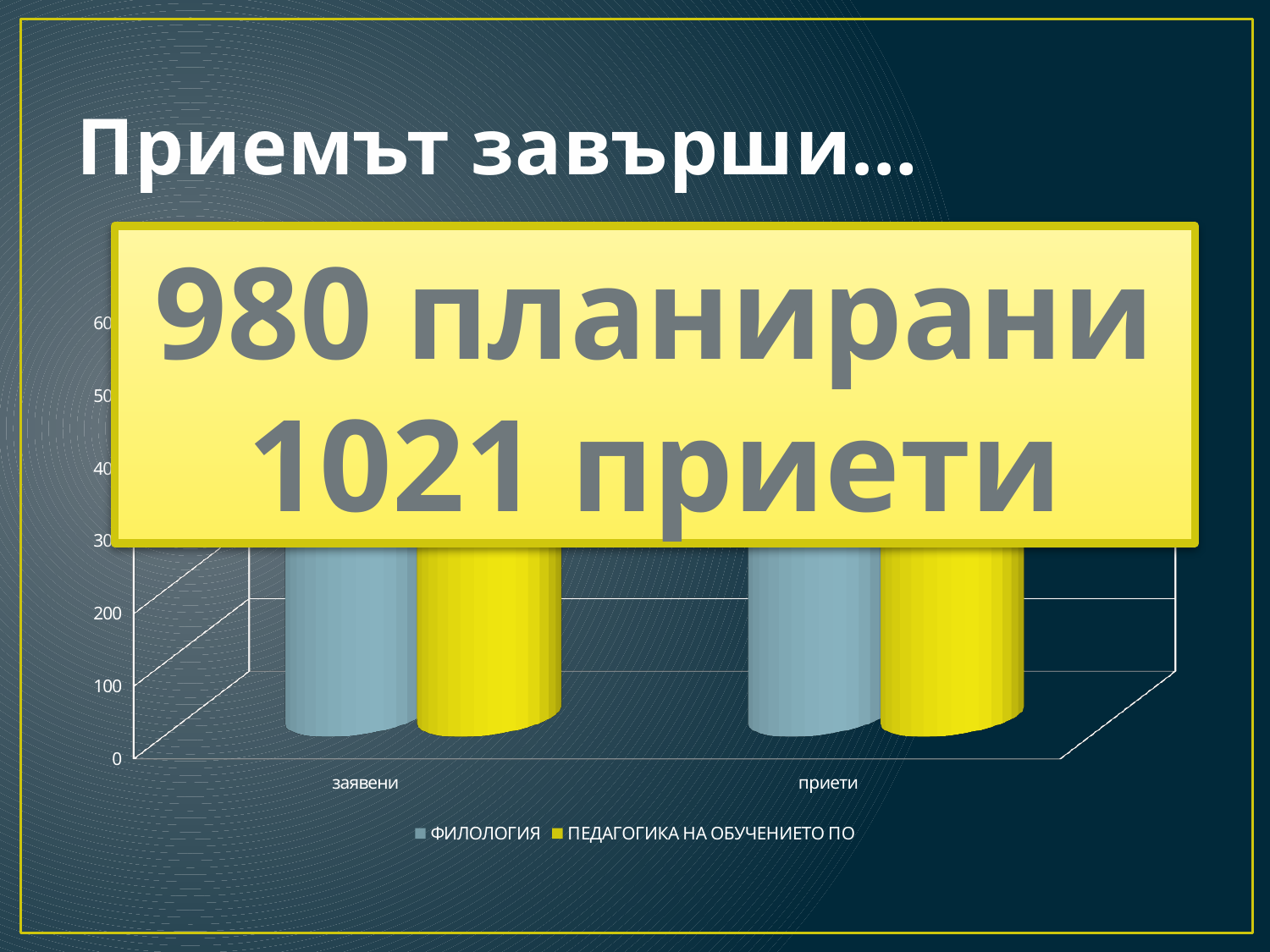
What is the lowest value shown on the chart's vertical axis? 0 How many series does the chart's legend list? 2 Is the value for ФИЛОЛОГИЯ in the заявени category greater or less than 200? greater What are the two categories on the x axis of the chart? заявени, приети Which series does the yellow bar represent in the chart? ПЕДАГОГИКА НА ОБУЧЕНИЕТО ПО How many categories are shown on the x axis of the chart? 2 What kind of chart is shown on the slide? bar chart Is the value for ПЕДАГОГИКА НА ОБУЧЕНИЕТО ПО in the заявени category greater or less than 200? greater Is the value for ПЕДАГОГИКА НА ОБУЧЕНИЕТО ПО in the приети category greater or less than 100? greater